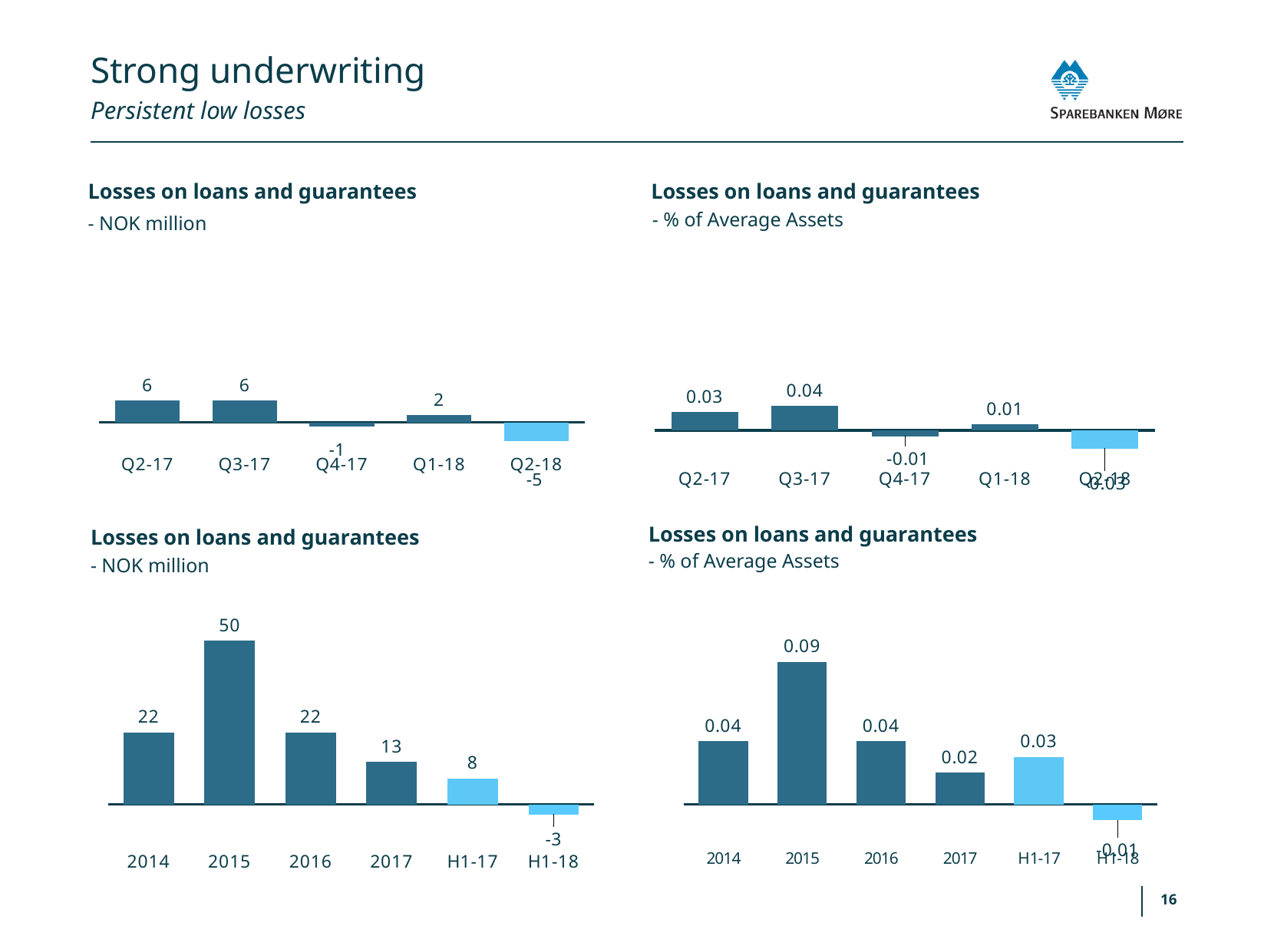
In the top-left chart (Losses on loans and guarantees, NOK million, quarterly), what is the value for Q2-17? 6 In the bottom-left chart (NOK million, annual), which is larger, the value for H1-17 or the value for 2017? 2017 In the bottom-right chart (% of Average Assets, annual), what is the value for 2015? 0.09 In the bottom-left chart (NOK million, annual), what is the difference between the values for 2015 and 2017? 37 In the bottom-left chart (NOK million, annual), what is the value for 2015? 50 In the top-left chart (NOK million, quarterly), what is the value for Q2-18? -5 In the top-left chart (NOK million, quarterly), which quarter has the lowest value? Q2-18 In the bottom-right chart (% of Average Assets, annual), what is the value for H1-17? 0.03 In the bottom-left chart (NOK million, annual), how many categories are shown on the x axis? 6 What type of chart is the bottom-left chart? Bar chart In the top-right chart (% of Average Assets, quarterly), which quarter has the highest value? Q3-17 In the top-right chart (% of Average Assets, quarterly), what is the value for Q3-17? 0.04